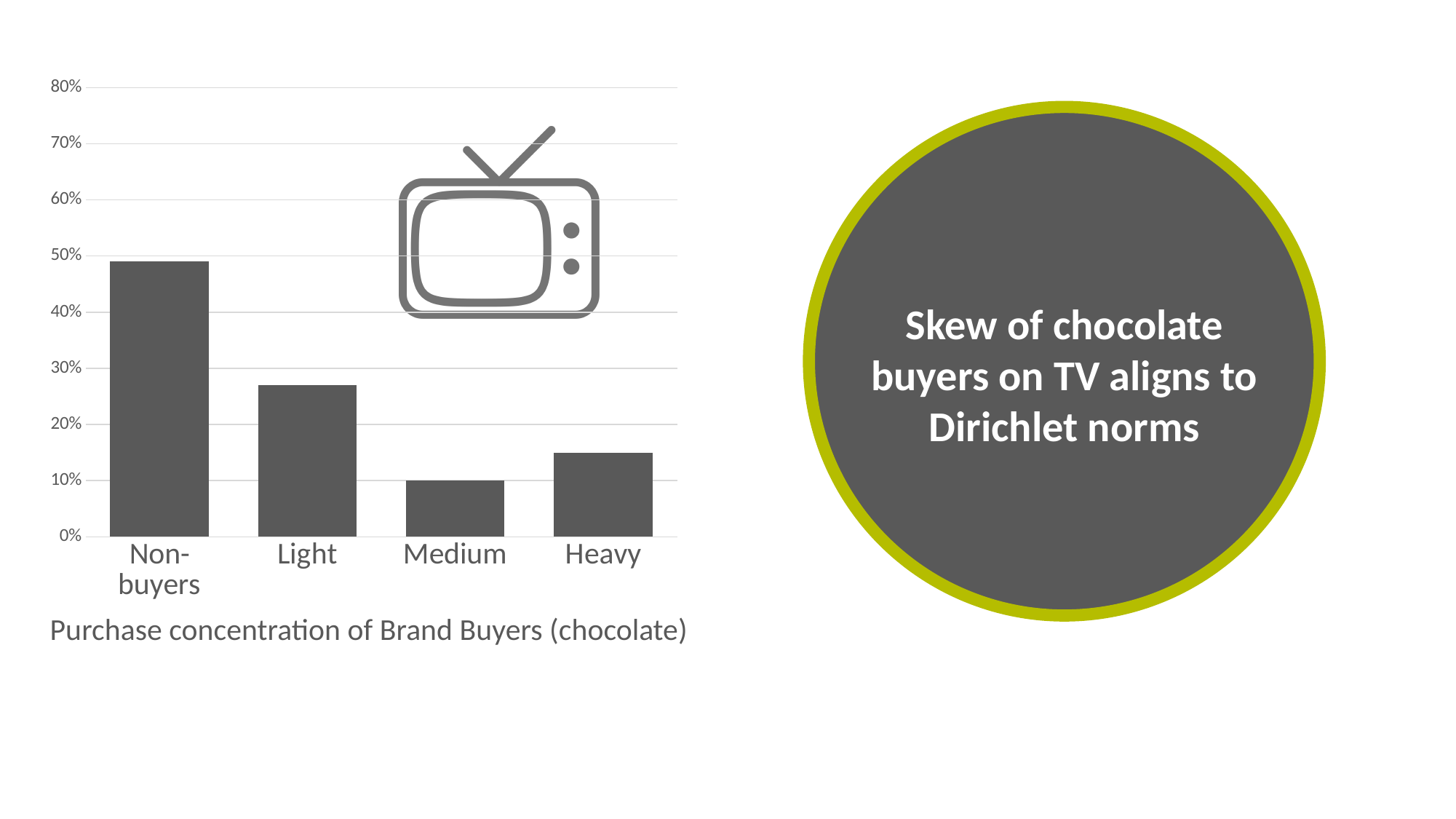
Is the value for Non-buyers greater or less than 40%? greater Which category has the lowest value in the chart? Medium Is the value for Light greater or less than 30%? less Do the values rise or fall from Non-buyers to Medium? fall Which category has the highest value in the chart? Non-buyers Which is larger, the value for Light or the value for Heavy? Light What is the value for Medium? 10% How many categories are shown on the x axis of the chart? 4 Is the value for Heavy greater or less than 20%? less What is the title of the chart? Purchase concentration of Brand Buyers (chocolate) Which is larger, the value for Heavy or the value for Medium? Heavy What kind of chart is shown on the slide? Bar chart